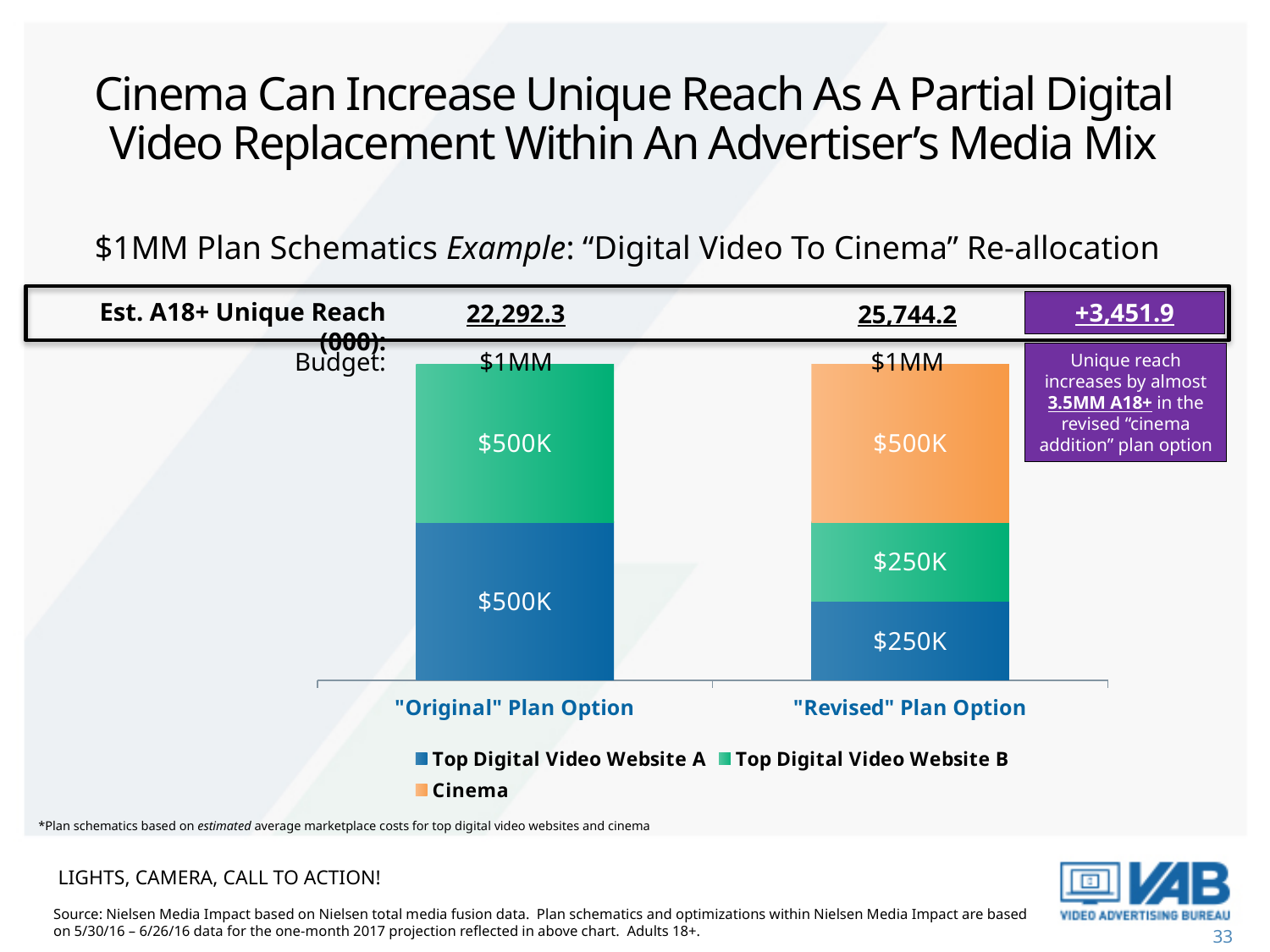
What is the estimated A18+ unique reach (000) shown for the "Revised" Plan Option? 25,744.2 How many series does the chart legend list? 3 What is the value for Top Digital Video Website A in the "Original" Plan Option? $500K What is the value for Top Digital Video Website B in the "Revised" Plan Option? $250K What is the total budget of the "Revised" Plan Option bar? $1MM Which plan option includes a Cinema segment? "Revised" Plan Option What kind of chart is shown on the slide? Stacked bar chart Which series is shown in orange in the chart? Cinema How many plan options are shown on the x axis of the chart? 2 What is the difference between the Top Digital Video Website A value in the "Original" Plan Option and in the "Revised" Plan Option? $250K What is the value for Cinema in the "Revised" Plan Option? $500K Which is larger in the "Revised" Plan Option: the Cinema value or the Top Digital Video Website A value? Cinema